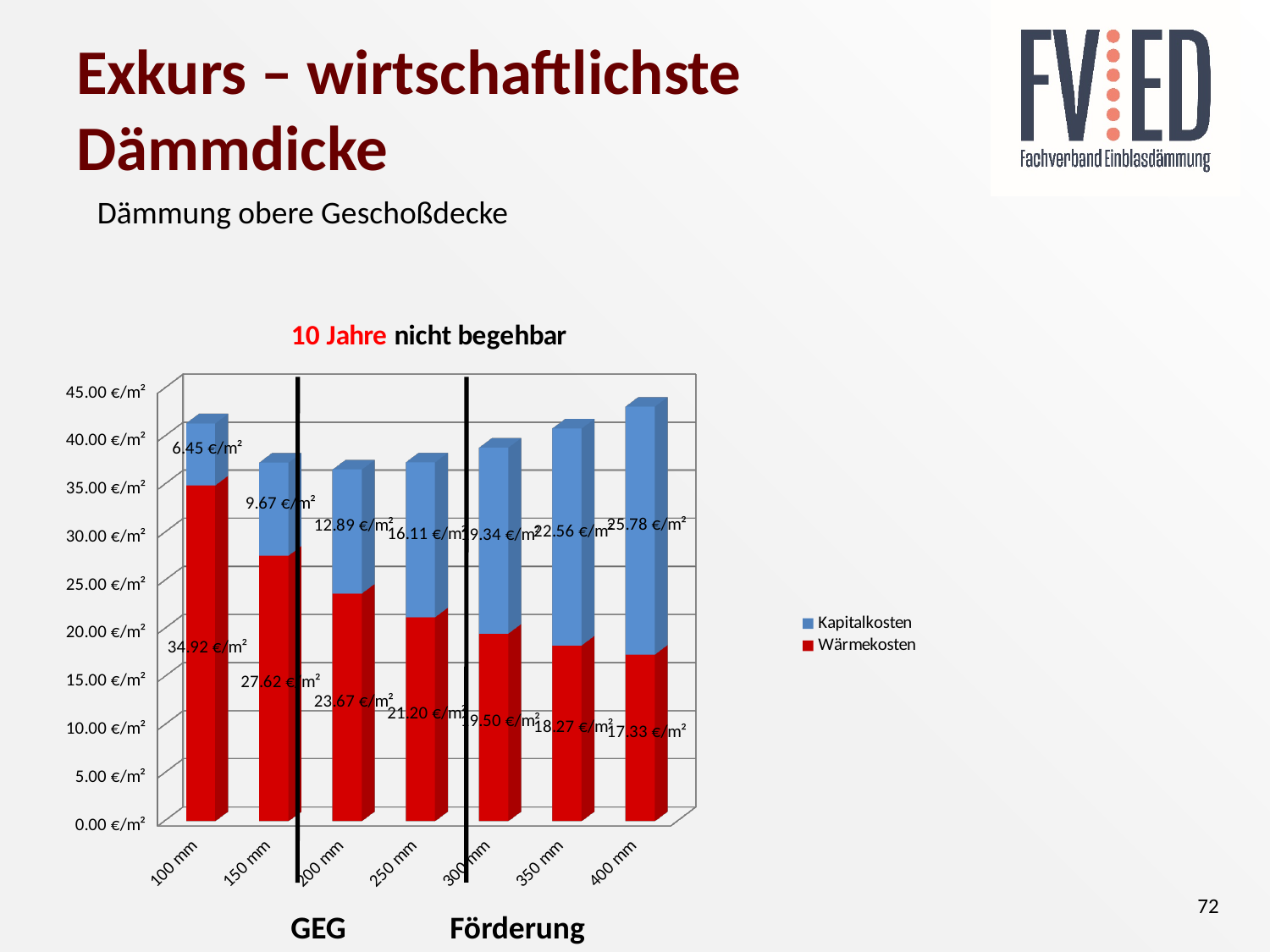
What kind of chart is shown? Stacked bar chart Which is larger: the Kapitalkosten value for 300 mm or the Wärmekosten value for 300 mm? Wärmekosten (19.50 €/m²) Which category has the highest Wärmekosten value? 100 mm How many series does the legend list? 2 Which category has the lowest Kapitalkosten value? 100 mm What is the Wärmekosten value for 100 mm? 34.92 €/m² What is the difference between the Wärmekosten values for 100 mm and 150 mm? 7.30 €/m² What is the Kapitalkosten value for 400 mm? 25.78 €/m² What is the Kapitalkosten value for 250 mm? 16.11 €/m² How many categories are shown on the x axis? 7 Do the Kapitalkosten values rise or fall as the insulation thickness increases from 100 mm to 400 mm? Rise What is the total of the stacked bar for 200 mm? 36.56 €/m²